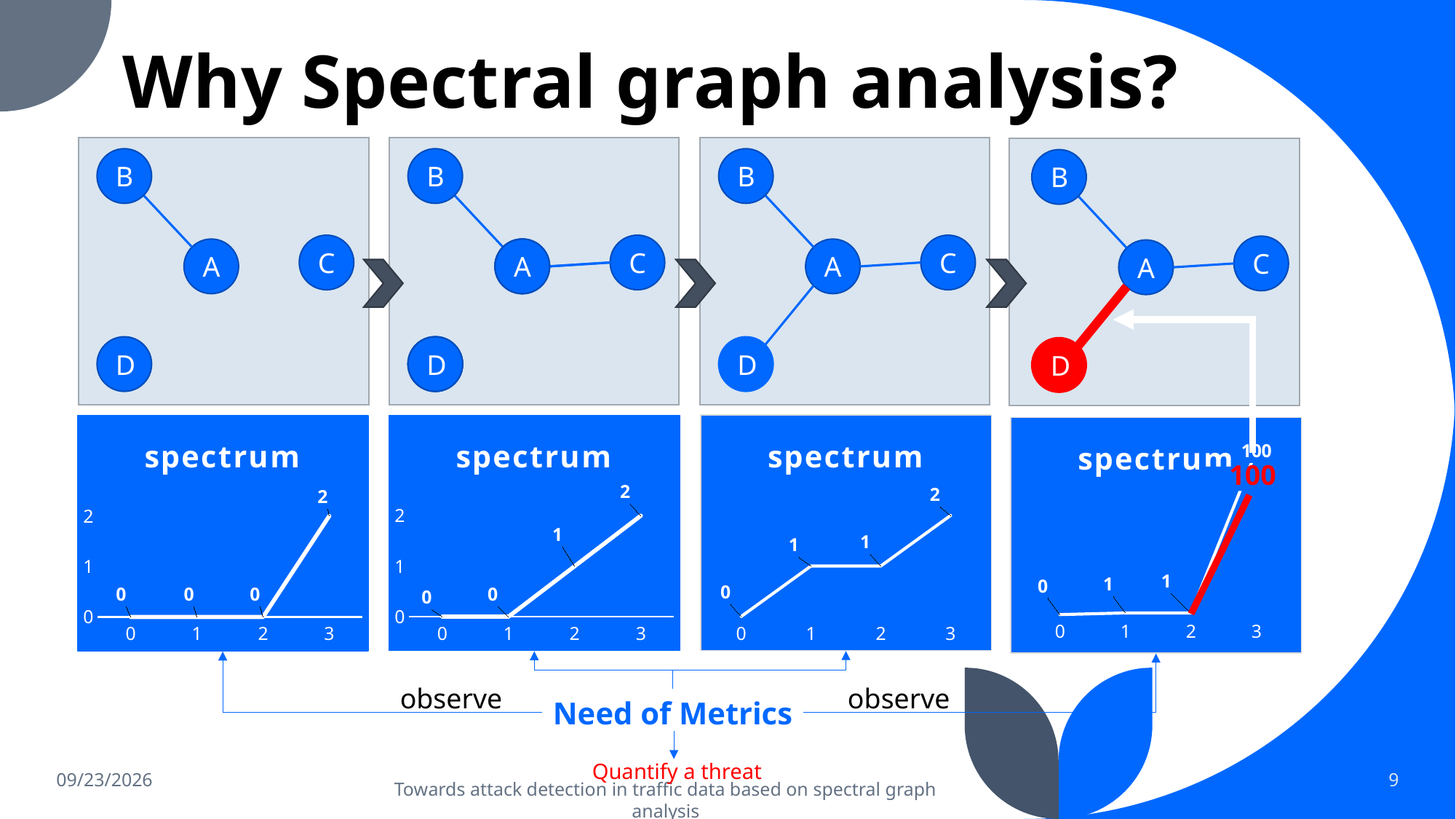
In the third spectrum chart from the left, at which x value is the plotted value highest? 3 In the leftmost spectrum chart, what is the value at x = 3? 2 In the leftmost spectrum chart, how many data points are plotted? 4 In the rightmost spectrum chart, what is the value at x = 3? 100 In the second spectrum chart from the left, what is the value at x = 2? 1 What is the title shared by the four charts on the slide? spectrum In the rightmost spectrum chart, do the values rise or fall from x = 0 to x = 3? rise In the leftmost spectrum chart, what is the value at x = 2? 0 What kind of chart is the leftmost spectrum chart? line chart In the second spectrum chart from the left, what is the difference between the values at x = 3 and x = 2? 1 In the third spectrum chart from the left, what is the value at x = 1? 1 In the rightmost spectrum chart, what is the difference between the values at x = 3 and x = 2? 99